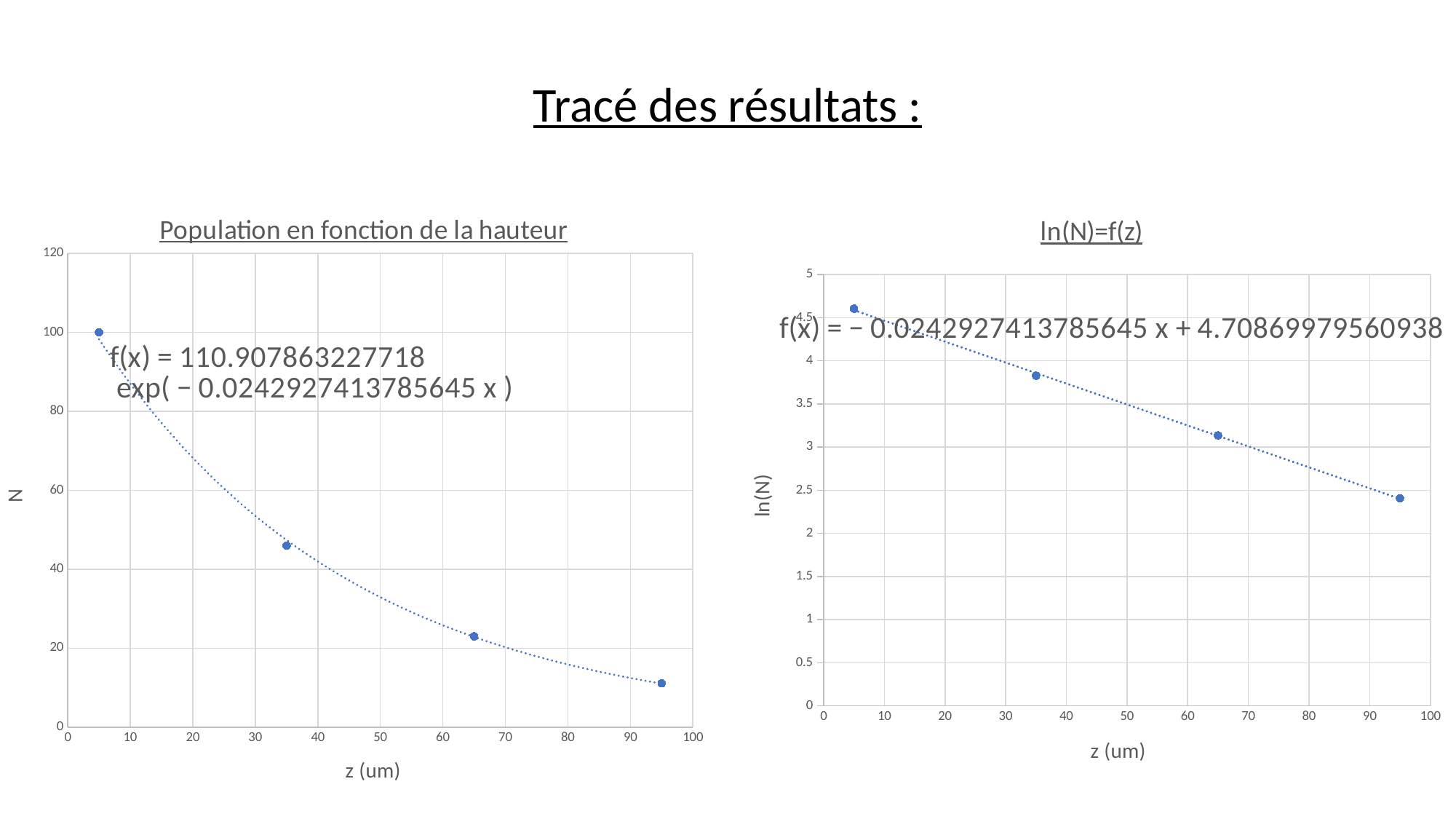
In the chart titled "Population en fonction de la hauteur", is the value of N at z = 35 greater or less than 40? greater In the chart titled "ln(N)=f(z)", which z value has the lowest ln(N)? 95 In the chart titled "ln(N)=f(z)", how many data points are plotted? 4 In the chart titled "ln(N)=f(z)", is the value of ln(N) at z = 95 greater or less than 2.5? less In the chart titled "Population en fonction de la hauteur", what kind of chart is it? scatter chart In the chart titled "Population en fonction de la hauteur", how many data points are plotted? 4 In the chart titled "ln(N)=f(z)", what is the label of the y axis? ln(N) In the chart titled "ln(N)=f(z)", do the values of ln(N) rise or fall as z increases? fall In the chart titled "ln(N)=f(z)", is the value of ln(N) at z = 65 greater or less than 3? greater In the chart titled "Population en fonction de la hauteur", do the values of N rise or fall as z increases? fall In the chart titled "Population en fonction de la hauteur", which z value has the highest N? 5